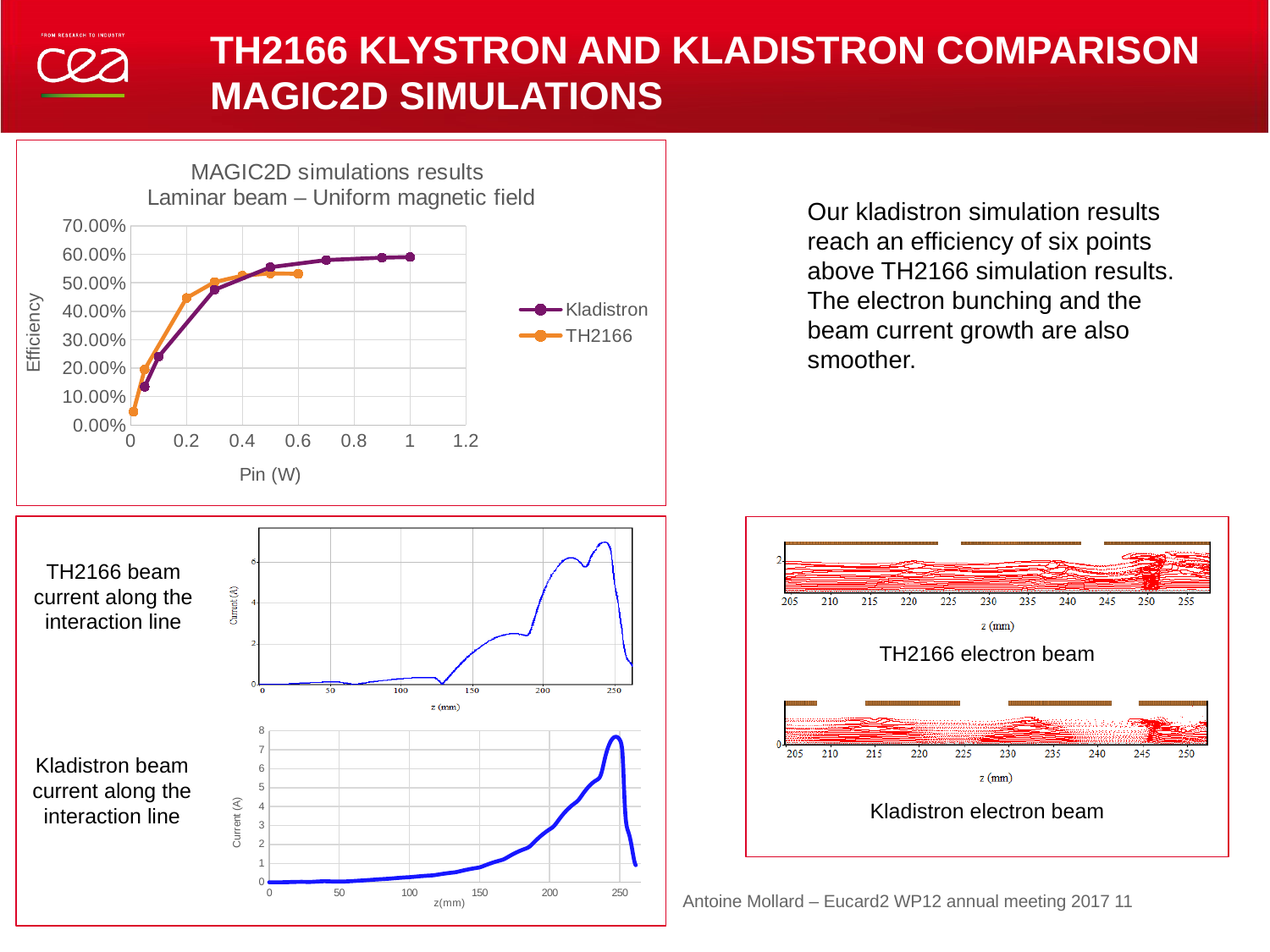
In the 'MAGIC2D simulations results' chart, which series is drawn in orange? TH2166 In the 'MAGIC2D simulations results' chart, is the TH2166 efficiency at Pin = 0.6 W greater or less than 60.00%? less What type of chart is the 'MAGIC2D simulations results' chart at the top left? line chart In the 'MAGIC2D simulations results' chart, is the Kladistron efficiency at Pin = 1 W greater or less than 50.00%? greater In the 'MAGIC2D simulations results' chart, which series reaches the higher maximum efficiency? Kladistron In the 'MAGIC2D simulations results' chart, does the Kladistron efficiency rise or fall as Pin increases? rise In the 'MAGIC2D simulations results' chart, is the Kladistron efficiency at Pin = 0.3 W greater or less than 40.00%? greater How many series does the legend of the 'MAGIC2D simulations results' chart list? 2 In the 'MAGIC2D simulations results' chart, what is the label of the x axis? Pin (W)